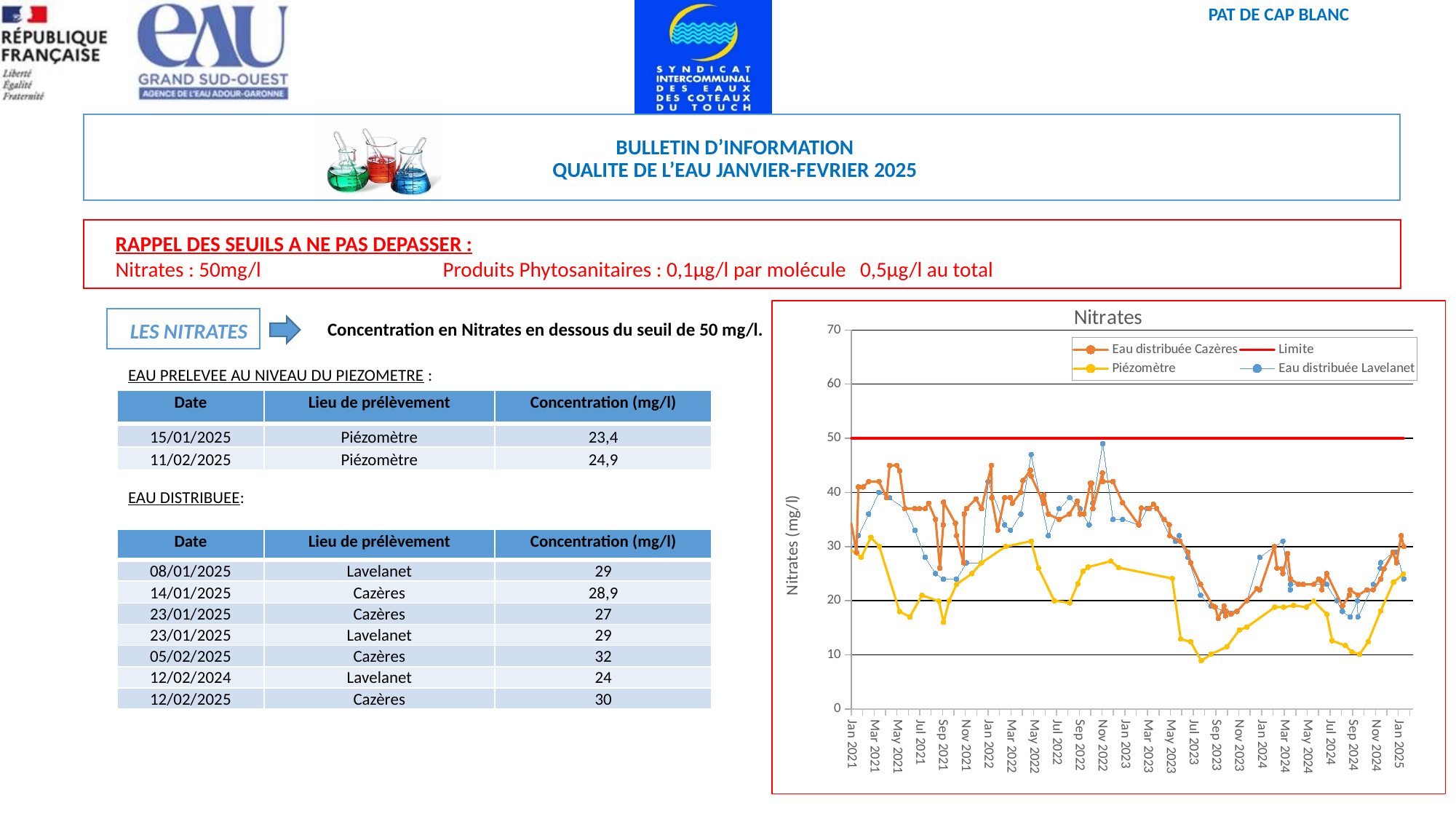
How many series does the legend of the Nitrates chart list? 4 Is the Piézomètre value in Jul 2023 greater or less than 20? less Does the Piézomètre series rise or fall between Jan 2023 and Jul 2023? fall Which series has the lowest values in the Nitrates chart? Piézomètre Is the Eau distribuée Lavelanet value in Nov 2022 greater or less than 40? greater What type of chart is shown on the slide? line chart Which series is generally lower across the chart, Piézomètre or Eau distribuée Cazères? Piézomètre What is the title of the chart on the slide? Nitrates At what value on the y axis is the Limite line drawn in the Nitrates chart? 50 What colour is the Limite line in the Nitrates chart? red Is the Eau distribuée Cazères value in Sep 2023 greater or less than 20? less